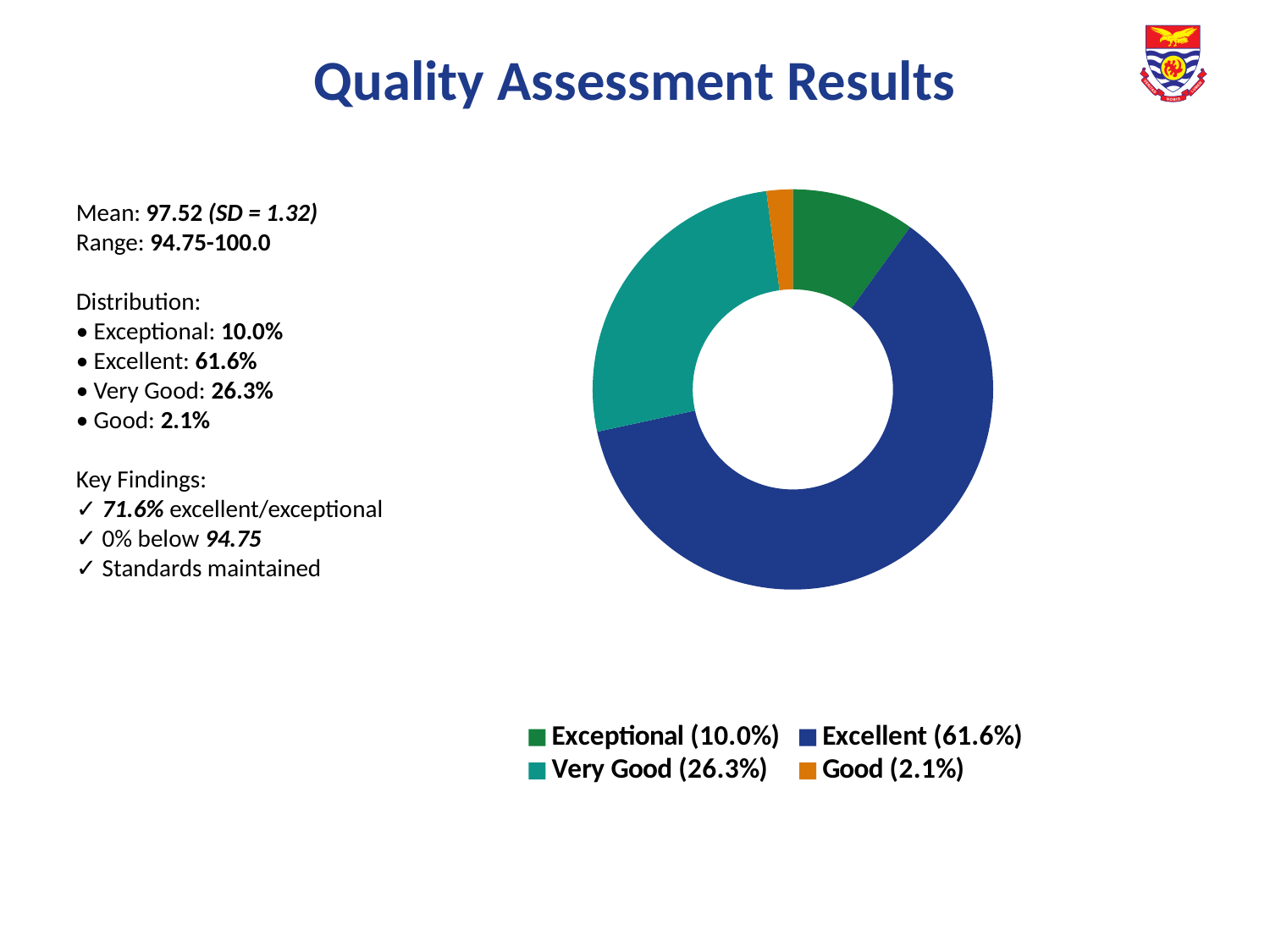
What colour is the Good slice in the chart? Orange What share of the chart does the Exceptional category represent? 10.0% What share of the chart does the Good category represent? 2.1% What kind of chart is shown on the slide? Doughnut (pie) chart What is the combined share of the Exceptional and Excellent slices? 71.6% What share of the chart does the Excellent category represent? 61.6% How many categories does the chart show? 4 Which category has the largest slice in the chart? Excellent What is the difference in percentage points between the Excellent and Very Good slices? 35.3 Which slice is larger, Exceptional or Very Good? Very Good Which category has the smallest slice in the chart? Good